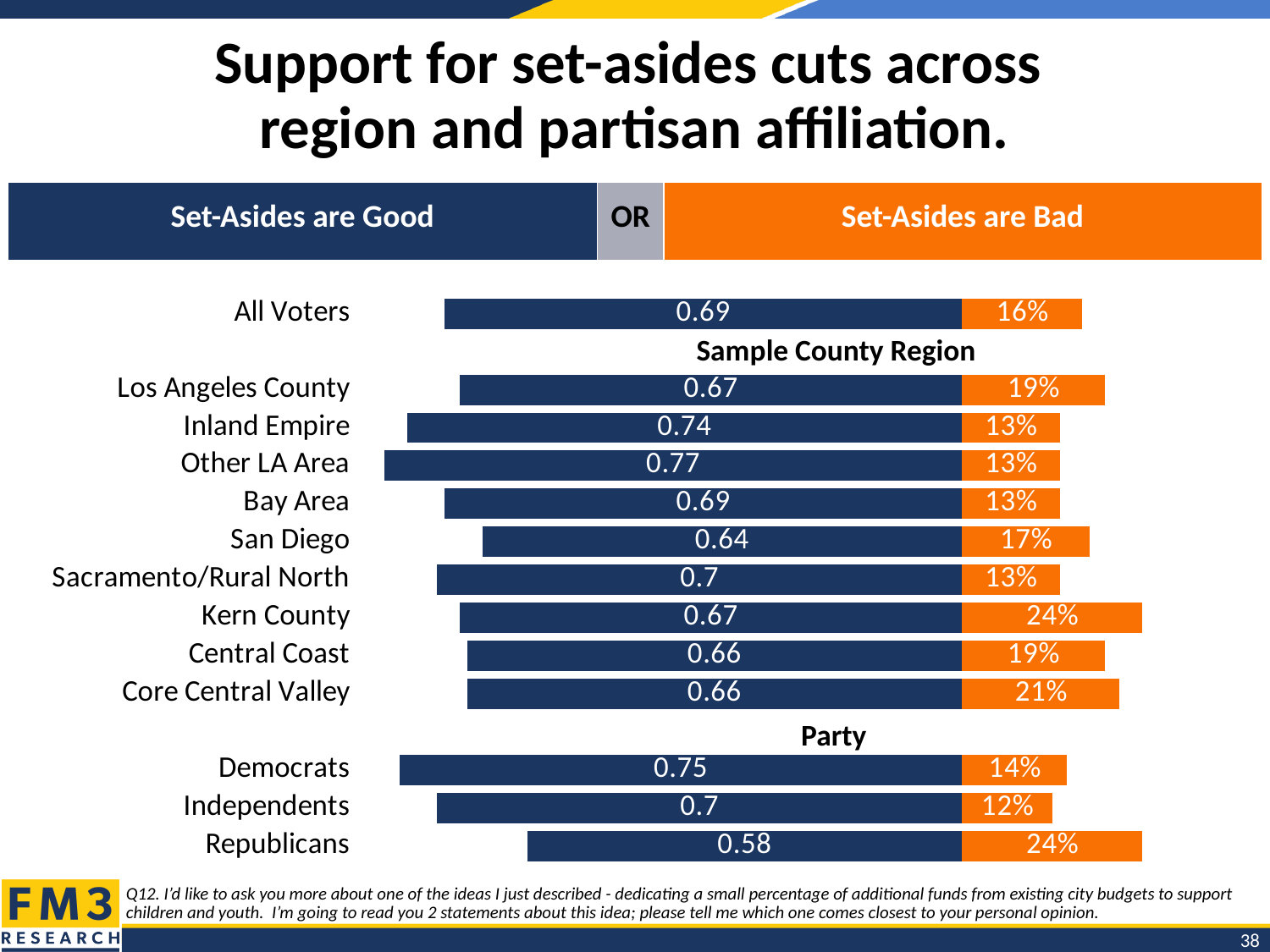
Which category has the lowest 'Set-Asides are Good' value? Republicans What is the 'Set-Asides are Good' value shown for Republicans? 0.58 What kind of chart is shown on the slide? Bar chart What is the 'Set-Asides are Good' value shown for All Voters? 0.69 What is the 'Set-Asides are Bad' value shown for Kern County? 24% Which has a larger 'Set-Asides are Good' value, Inland Empire or San Diego? Inland Empire What is the difference between the 'Set-Asides are Good' values for Democrats and Republicans? 0.17 What is the difference between the 'Set-Asides are Bad' values for Kern County and Inland Empire? 11% Which category has the lowest 'Set-Asides are Bad' value? Independents What is the 'Set-Asides are Bad' value shown for Independents? 12% How many categories are plotted in the chart? 13 Which category has the highest 'Set-Asides are Good' value? Other LA Area